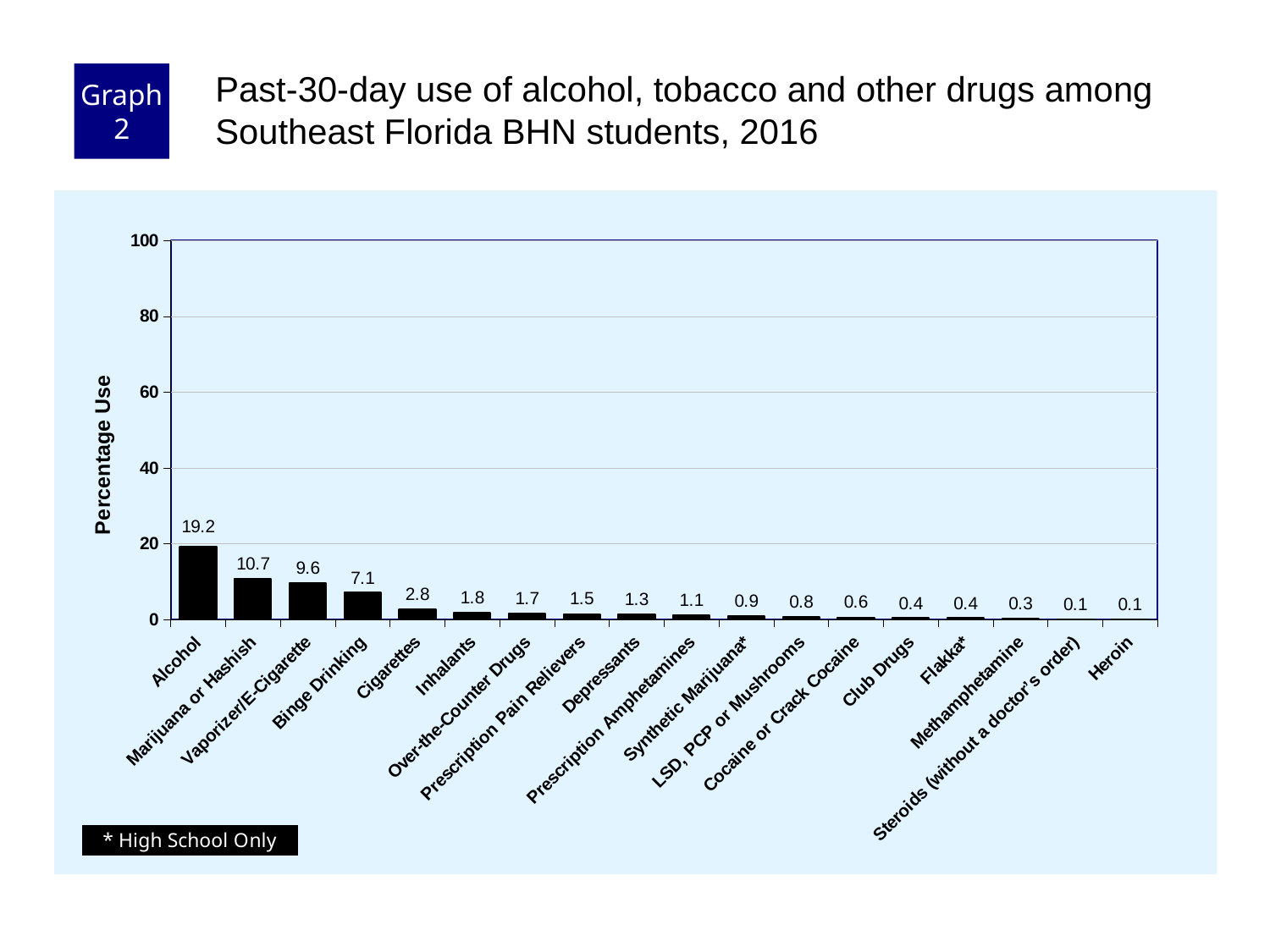
What is the difference in percentage use between Binge Drinking and Cigarettes? 4.3 How many categories are shown on the x axis? 18 What is the percentage use for Alcohol? 19.2 Which has a higher percentage use, Inhalants or Over-the-Counter Drugs? Inhalants What kind of chart is shown on the slide? bar chart What is the percentage use for Cigarettes? 2.8 Is the value for Alcohol greater or less than 20? less What is the label of the y axis? Percentage Use What is the percentage use for Vaporizer/E-Cigarette? 9.6 What is the difference in percentage use between Alcohol and Marijuana or Hashish? 8.5 What is the percentage use for Synthetic Marijuana? 0.9 Which category has the highest percentage use? Alcohol